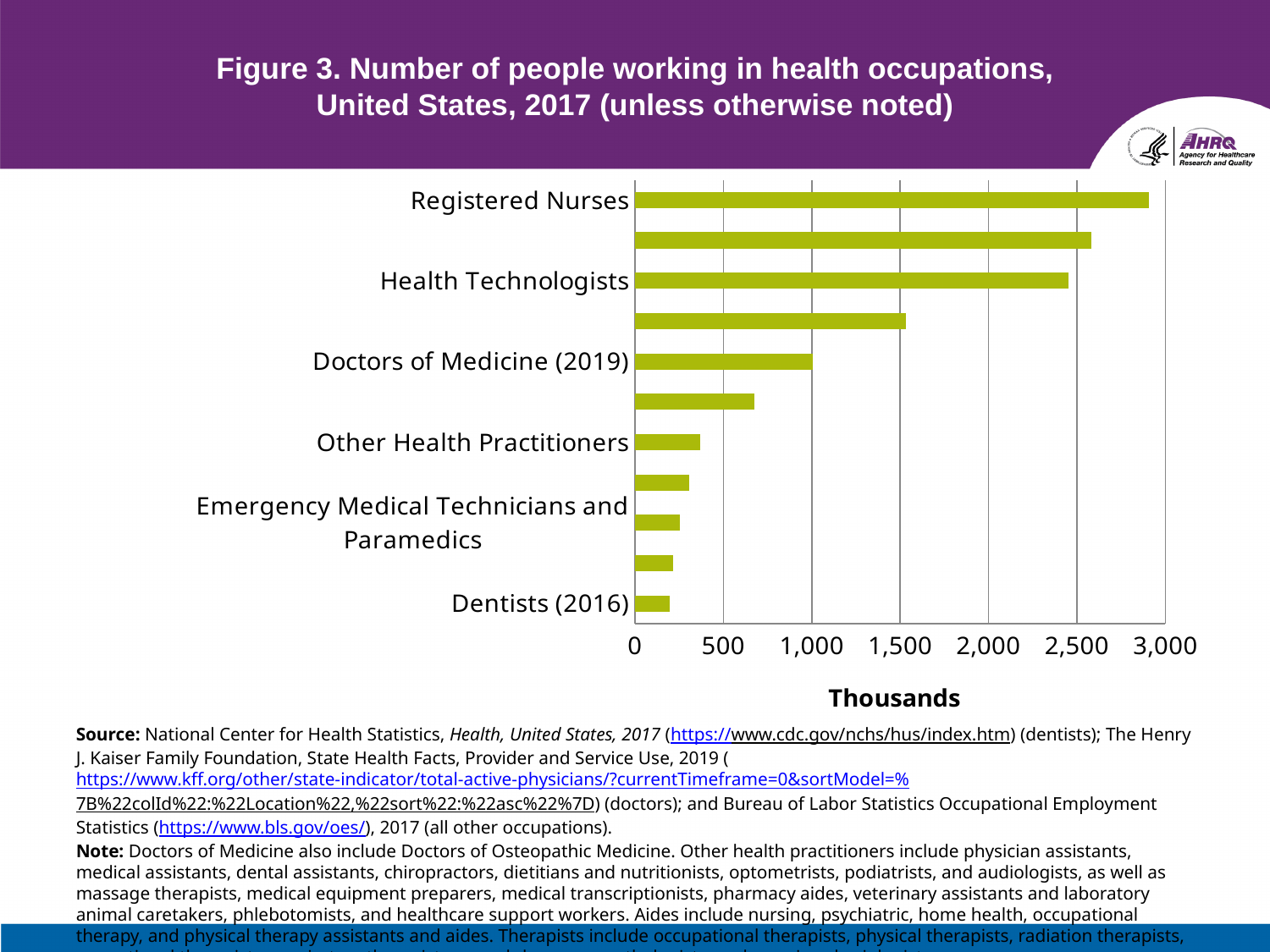
Is the value for Dentists (2016) greater or less than 500? less Which is larger, the value for Doctors of Medicine (2019) or the value for Emergency Medical Technicians and Paramedics? Doctors of Medicine (2019) What unit is given for the horizontal axis of the chart? Thousands Is the value for Doctors of Medicine (2019) greater or less than 1,500? less Which category has the highest value in the chart? Registered Nurses Is the value for Registered Nurses greater or less than 2,500? greater Do the bars get longer or shorter going from the top of the chart to the bottom? shorter Which is larger, the value for Registered Nurses or the value for Health Technologists? Registered Nurses What kind of chart is shown on the slide? Bar chart How many bars are plotted in the chart? 11